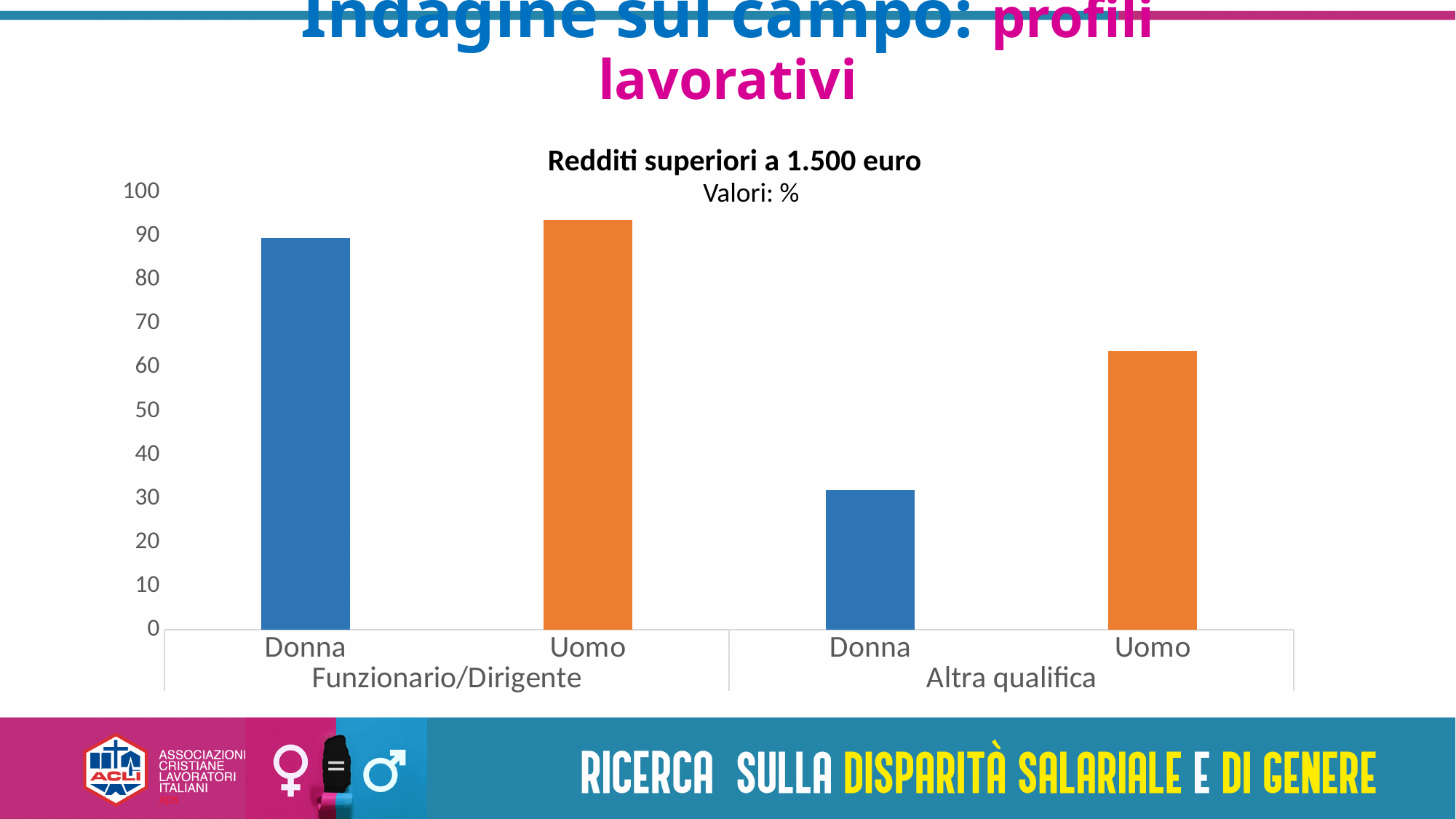
Which bar has the highest value? Uomo (Funzionario/Dirigente) Is the value for Uomo in the Funzionario/Dirigente group greater or less than 90? greater Is the value for Donna in the Funzionario/Dirigente group greater or less than 80? greater Which is larger, the value for Donna in the Funzionario/Dirigente group or the value for Uomo in the Altra qualifica group? Donna (Funzionario/Dirigente) Is the value for Donna in the Altra qualifica group greater or less than 40? less In what unit are the values expressed, according to the chart subtitle? % In the Altra qualifica group, which is larger, the value for Donna or for Uomo? Uomo What kind of chart is shown on the slide? bar chart What is the title of the chart? Redditi superiori a 1.500 euro How many bars are plotted in the chart? 4 Which bar has the lowest value? Donna (Altra qualifica)